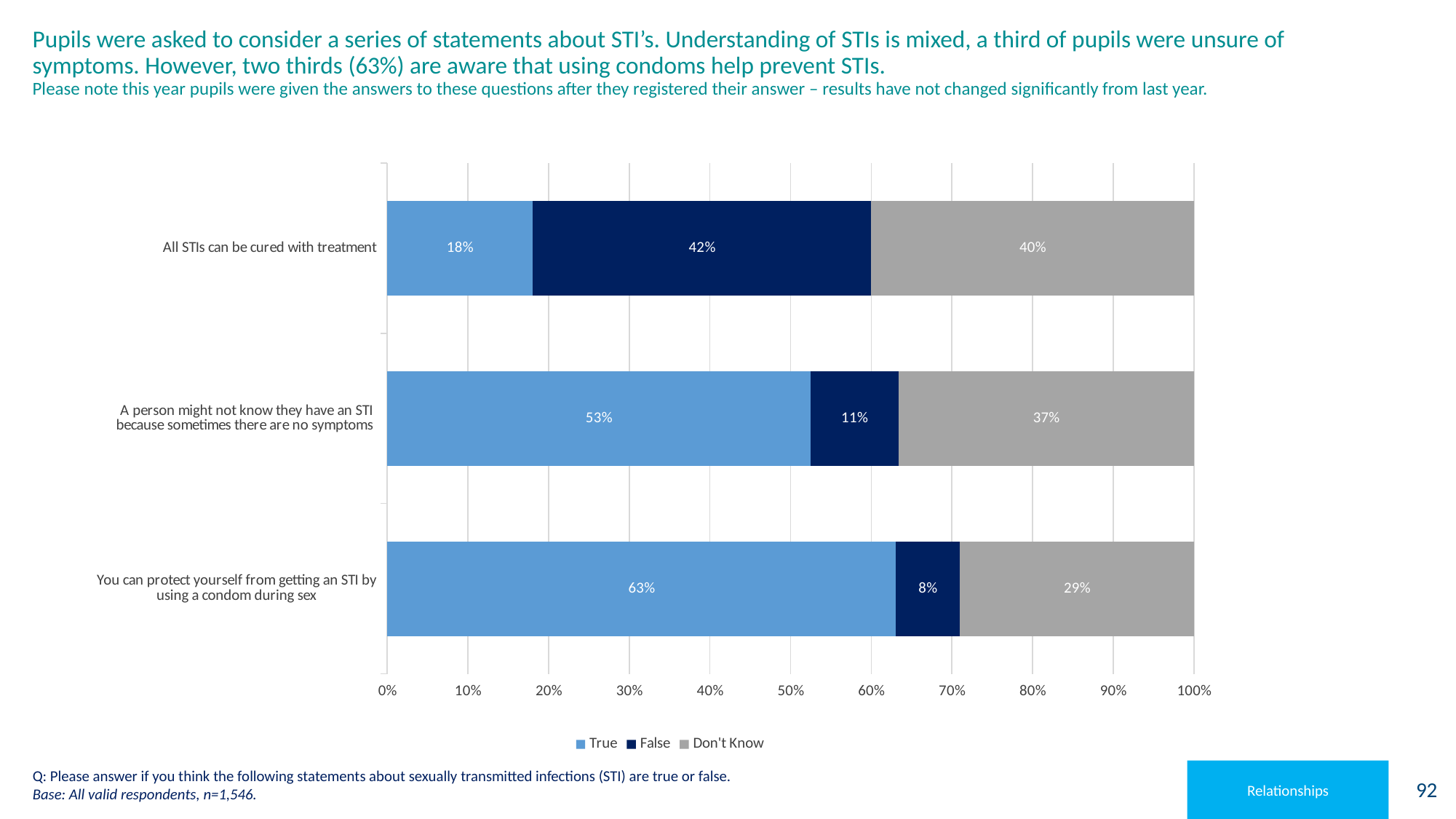
Which colour represents 'Don't Know' in the chart? Grey Which statement has the lowest 'Don't Know' percentage? You can protect yourself from getting an STI by using a condom during sex For the statement 'All STIs can be cured with treatment', which is larger: the 'False' share or the 'Don't Know' share? False What type of chart is shown on the slide? Stacked bar chart How many series does the legend list? 3 Which statement has the highest 'True' percentage? You can protect yourself from getting an STI by using a condom during sex How many statements are shown in the chart? 3 What percentage of pupils answered 'Don't Know' to the statement 'A person might not know they have an STI because sometimes there are no symptoms'? 37% What percentage of pupils answered 'False' to the statement 'You can protect yourself from getting an STI by using a condom during sex'? 8% What is the total of the 'True' and 'False' percentages for the statement 'A person might not know they have an STI because sometimes there are no symptoms'? 64% What is the difference between the 'False' percentage for 'All STIs can be cured with treatment' and the 'False' percentage for 'A person might not know they have an STI because sometimes there are no symptoms'? 31% What percentage of pupils answered 'True' to the statement 'All STIs can be cured with treatment'? 18%